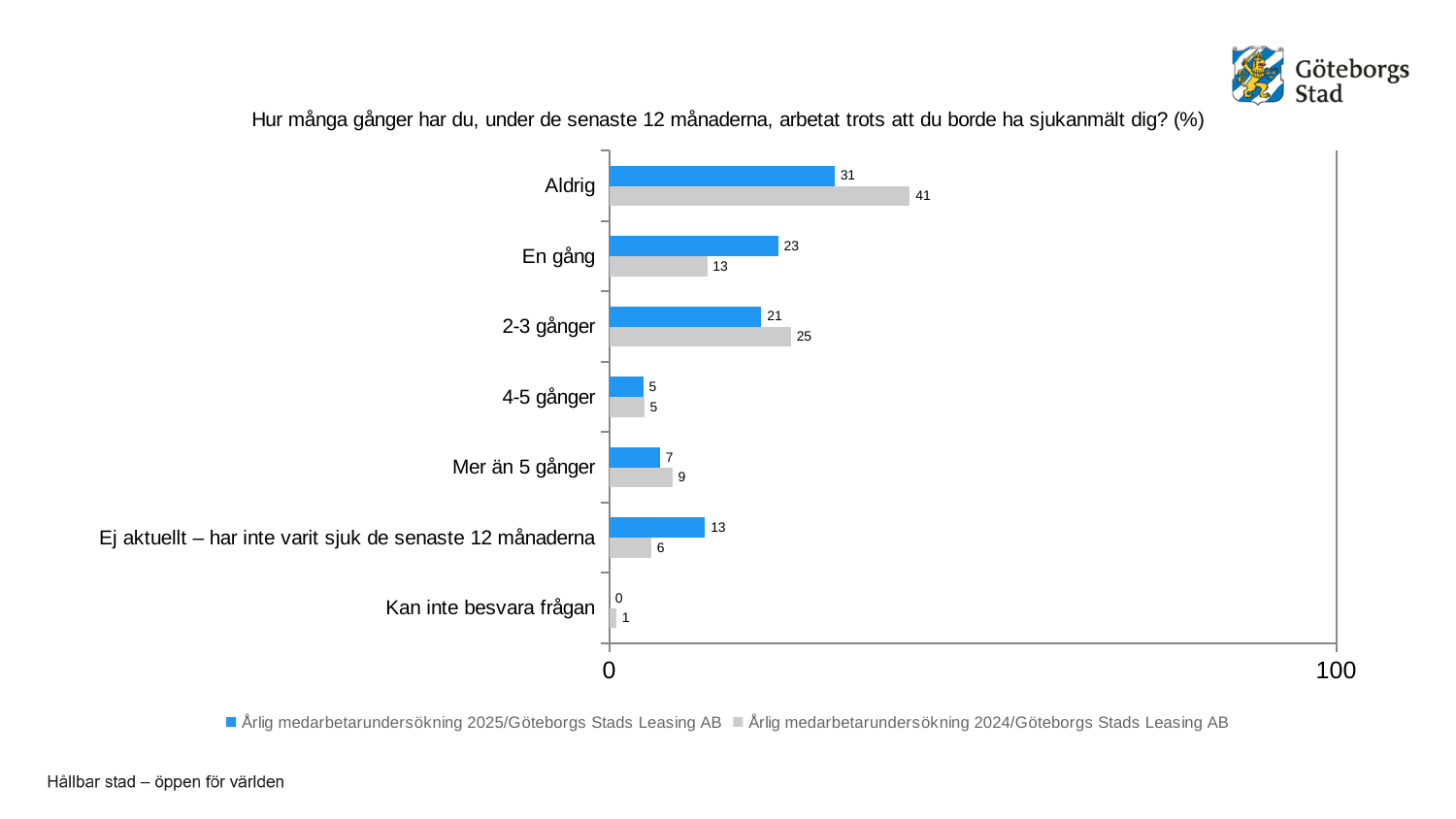
What is the value for "Ej aktuellt – har inte varit sjuk de senaste 12 månaderna" in the 2025 survey? 13 What is the value for "Aldrig" in the 2025 survey (Årlig medarbetarundersökning 2025)? 31 Which category has the lowest value in the 2025 survey? Kan inte besvara frågan Which category has the highest value in the 2024 survey? Aldrig What is the difference between the 2024 and 2025 values for "Aldrig"? 10 Which is larger for "2-3 gånger": the 2025 value or the 2024 value? 2024 value How many categories are shown on the chart? 7 Which colour represents the 2025 survey (Årlig medarbetarundersökning 2025) in the legend? Blue What kind of chart is shown on the slide? Bar chart How many series does the legend list? 2 What is the difference between the 2025 and 2024 values for "En gång"? 10 What is the value for "En gång" in the 2024 survey (Årlig medarbetarundersökning 2024)? 13